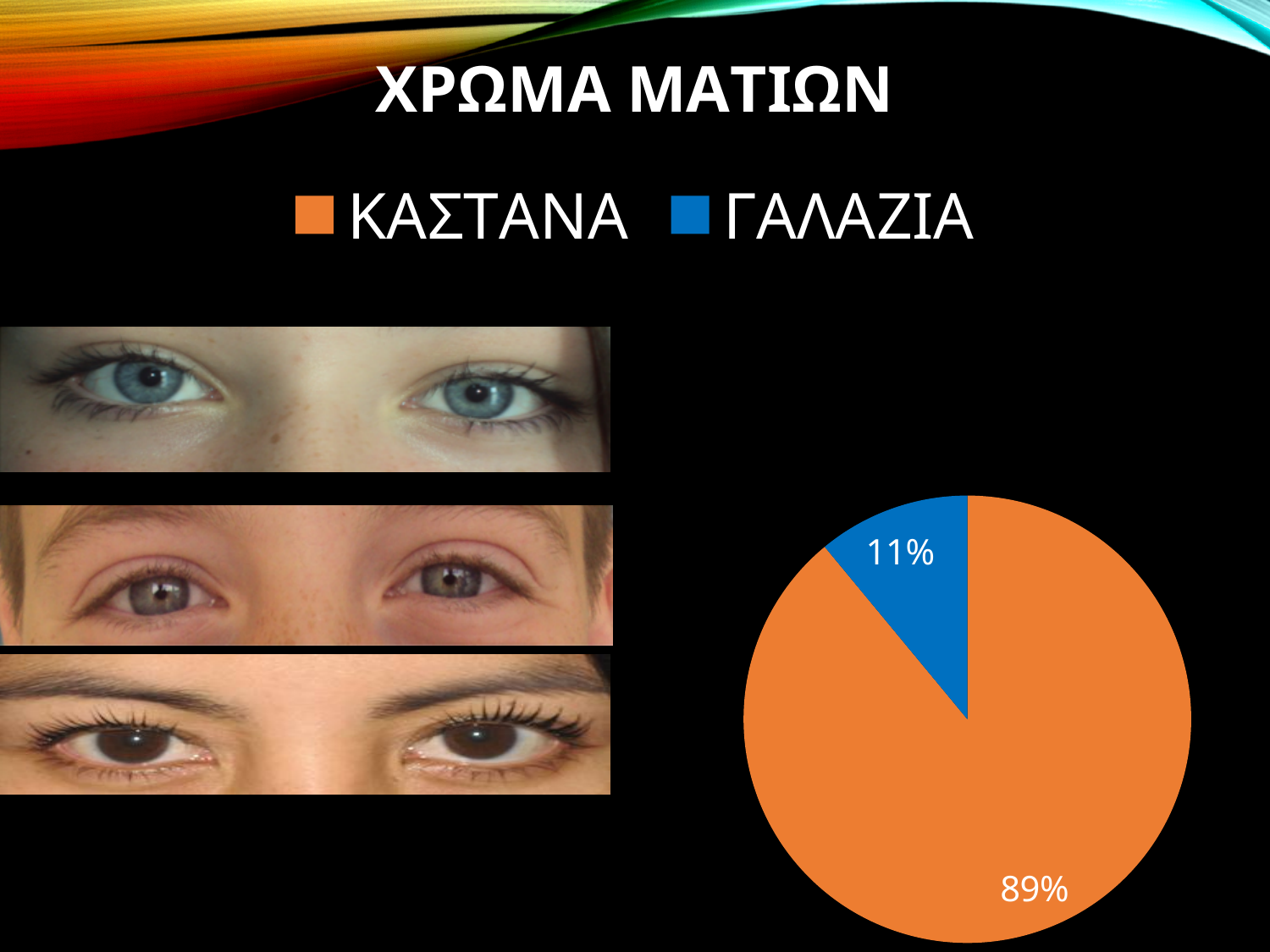
What share of the pie does ΓΑΛΑΖΙΑ have? 11% What kind of chart is shown on the slide? pie chart How many entries does the legend list? 2 What is the difference in percentage points between ΚΑΣΤΑΝΑ and ΓΑΛΑΖΙΑ? 78 How many categories does the pie chart show? 2 Which category has the largest slice of the pie? ΚΑΣΤΑΝΑ What colour is the slice for ΓΑΛΑΖΙΑ? blue Which category has the smallest slice of the pie? ΓΑΛΑΖΙΑ What share of the pie does ΚΑΣΤΑΝΑ have? 89% What is the title of the chart? ΧΡΩΜΑ ΜΑΤΙΩΝ Which is larger, the share for ΚΑΣΤΑΝΑ or the share for ΓΑΛΑΖΙΑ? ΚΑΣΤΑΝΑ